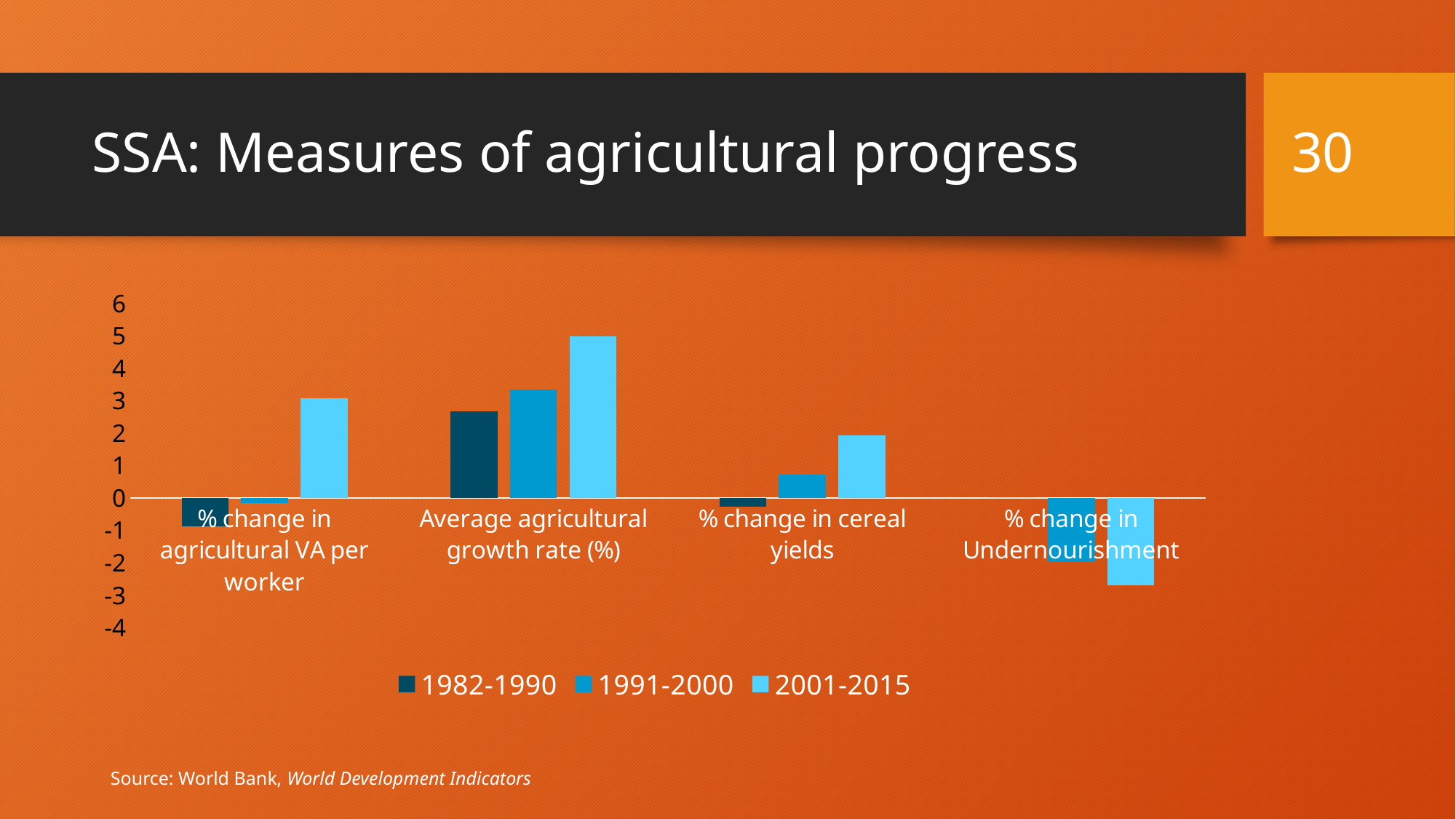
Which category has the lowest value for the 2001-2015 series? % change in Undernourishment Is the 2001-2015 value for Average agricultural growth rate (%) greater or less than 4? greater What kind of chart is shown on the slide? bar chart What is the title of the slide containing the chart? SSA: Measures of agricultural progress Is the 2001-2015 value for % change in Undernourishment greater or less than -2? less How many categories are shown on the x axis? 4 Which is larger for % change in agricultural VA per worker: the 1982-1990 value or the 2001-2015 value? 2001-2015 How many series does the legend list? 3 Is the 1982-1990 value for Average agricultural growth rate (%) greater or less than 2? greater Which series has the highest value for Average agricultural growth rate (%)? 2001-2015 Which is larger for % change in cereal yields: the 1991-2000 value or the 2001-2015 value? 2001-2015 Which category has the tallest bar for the 2001-2015 series? Average agricultural growth rate (%)